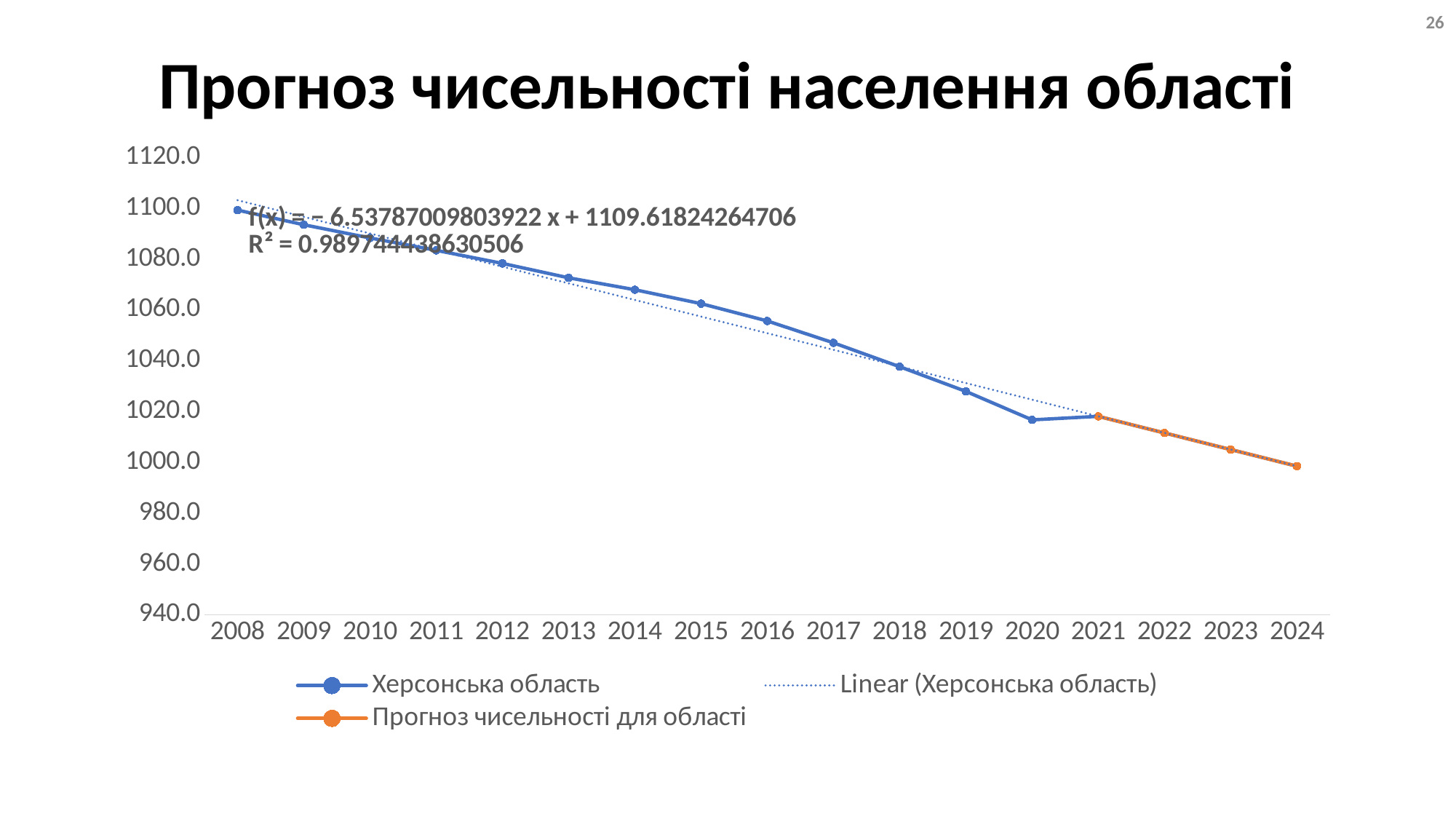
Is the value for 2016 greater or less than 1040? greater Is the value for 2022 greater or less than 1020? less Which year has the lowest value on the chart? 2024 How many entries does the chart legend list? 3 How many years are shown along the x axis? 17 What is the title of the chart? Прогноз чисельності населення області Is the value for 2008 greater or less than 1080? greater What kind of chart is shown on the slide? line chart Do the plotted values rise or fall from 2008 to 2024? fall What R² value is printed on the chart for the linear trendline? 0.989744438630506 Which is larger, the value for 2010 or the value for 2015? 2010 Which year has the highest value on the chart? 2008